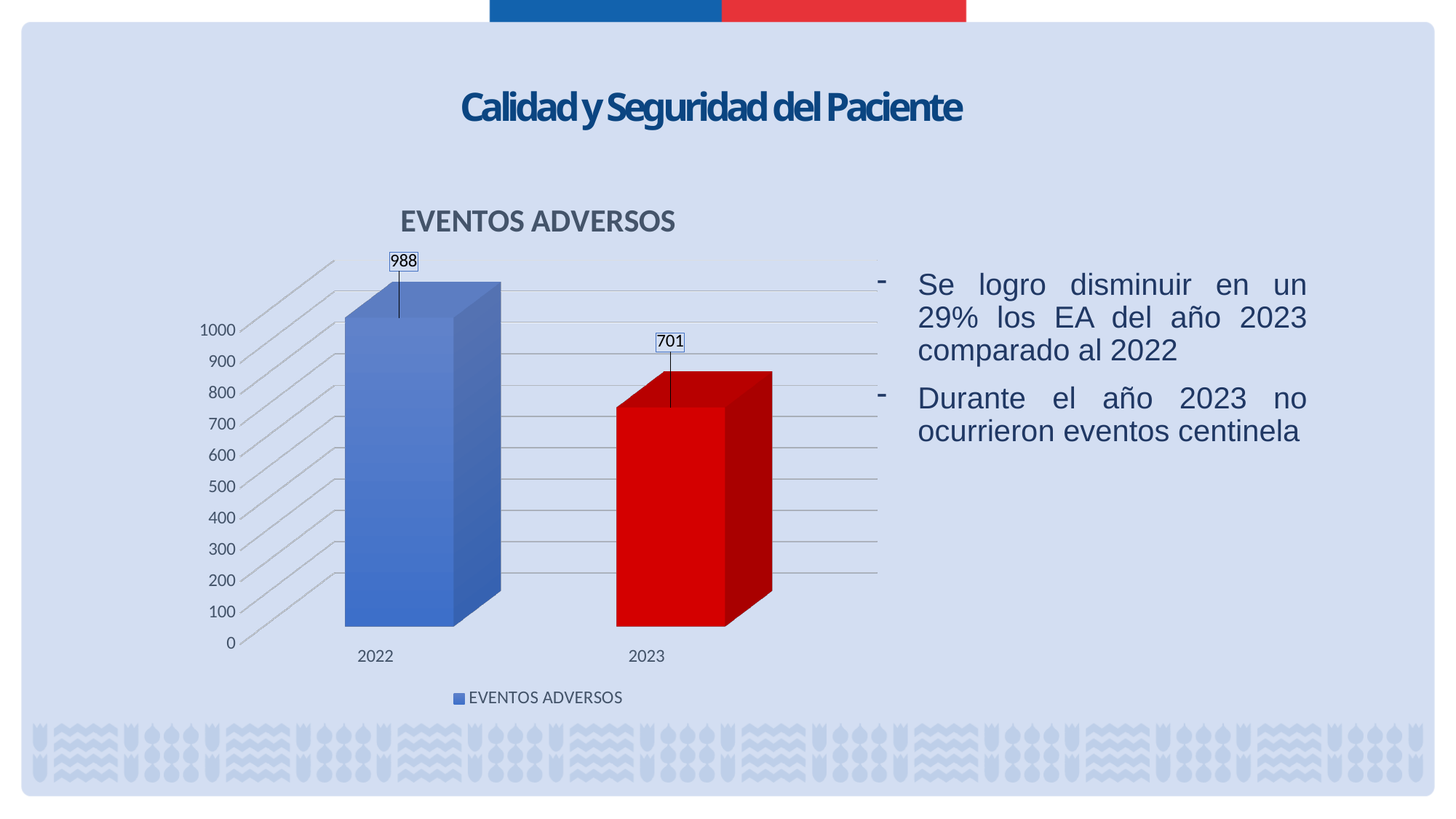
Which year has the highest value in the EVENTOS ADVERSOS chart? 2022 What is the difference between the 2022 and 2023 values in the EVENTOS ADVERSOS chart? 287 Is the value for 2023 in the EVENTOS ADVERSOS chart greater or less than 800? less What is the value for 2022 in the EVENTOS ADVERSOS chart? 988 What kind of chart is the EVENTOS ADVERSOS chart? bar chart What is the value for 2023 in the EVENTOS ADVERSOS chart? 701 How many categories are shown on the x axis of the EVENTOS ADVERSOS chart? 2 Which year has the lowest value in the EVENTOS ADVERSOS chart? 2023 Is the value for 2022 in the EVENTOS ADVERSOS chart greater or less than 900? greater Do the values in the EVENTOS ADVERSOS chart rise or fall from 2022 to 2023? fall How many series does the legend of the EVENTOS ADVERSOS chart list? 1 Which is larger in the EVENTOS ADVERSOS chart, the value for 2022 or for 2023? 2022